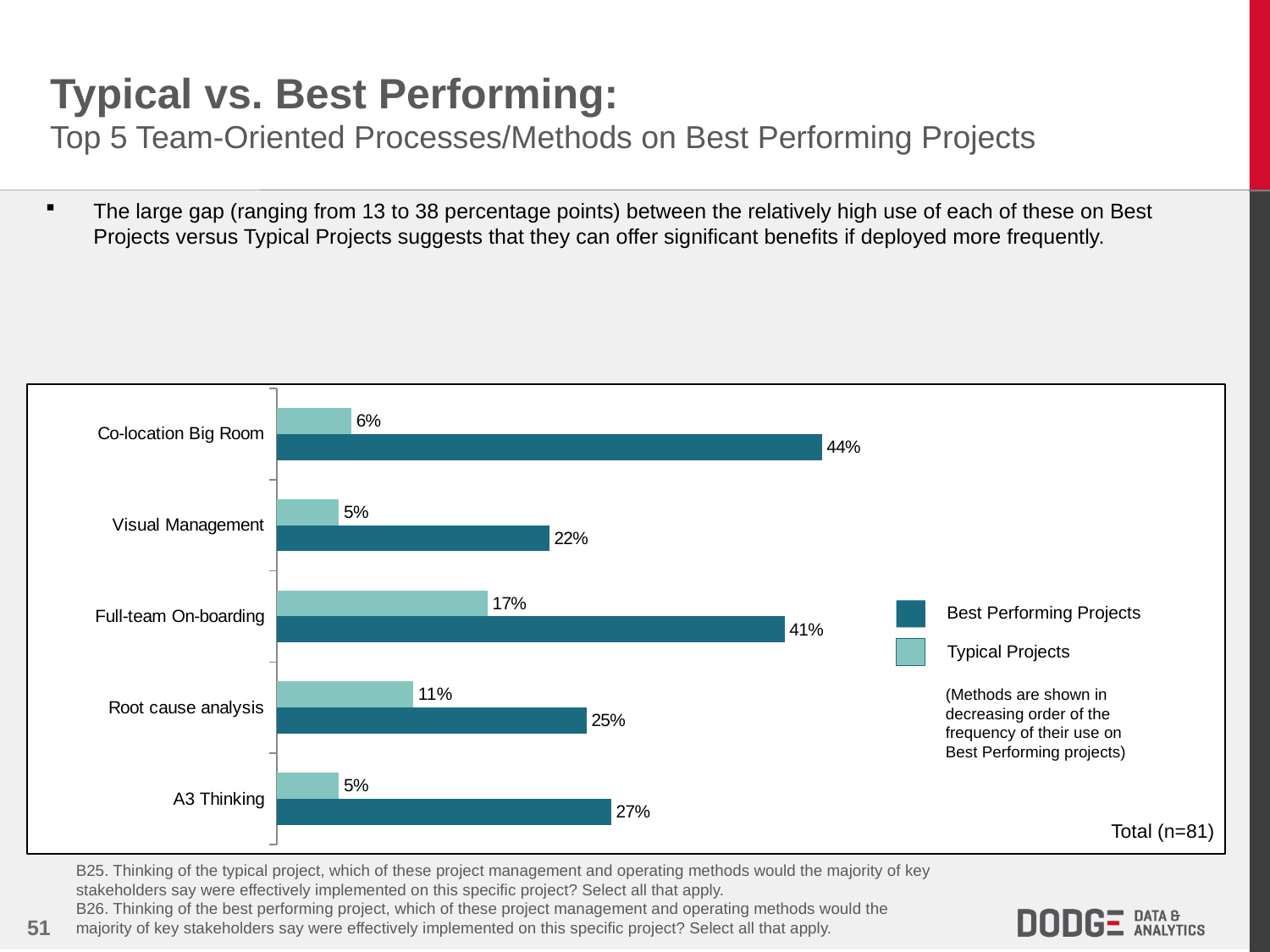
Which method has the highest value for Typical Projects? Full-team On-boarding Which is larger: the Best Performing Projects value for A3 Thinking or for Root cause analysis? A3 Thinking What is the value for Typical Projects for Root cause analysis? 11% How many series does the legend list? 2 What percentage of Typical Projects use Full-team On-boarding? 17% What is the difference between Best Performing Projects and Typical Projects for Root cause analysis? 14 percentage points How many methods are shown in the chart? 5 What type of chart is shown on the slide? Bar chart What is the difference between Best Performing Projects and Typical Projects for Co-location Big Room? 38 percentage points Which method has the highest value for Best Performing Projects? Co-location Big Room Which method has the lowest value for Best Performing Projects? Visual Management What percentage of Best Performing Projects use Co-location Big Room? 44%